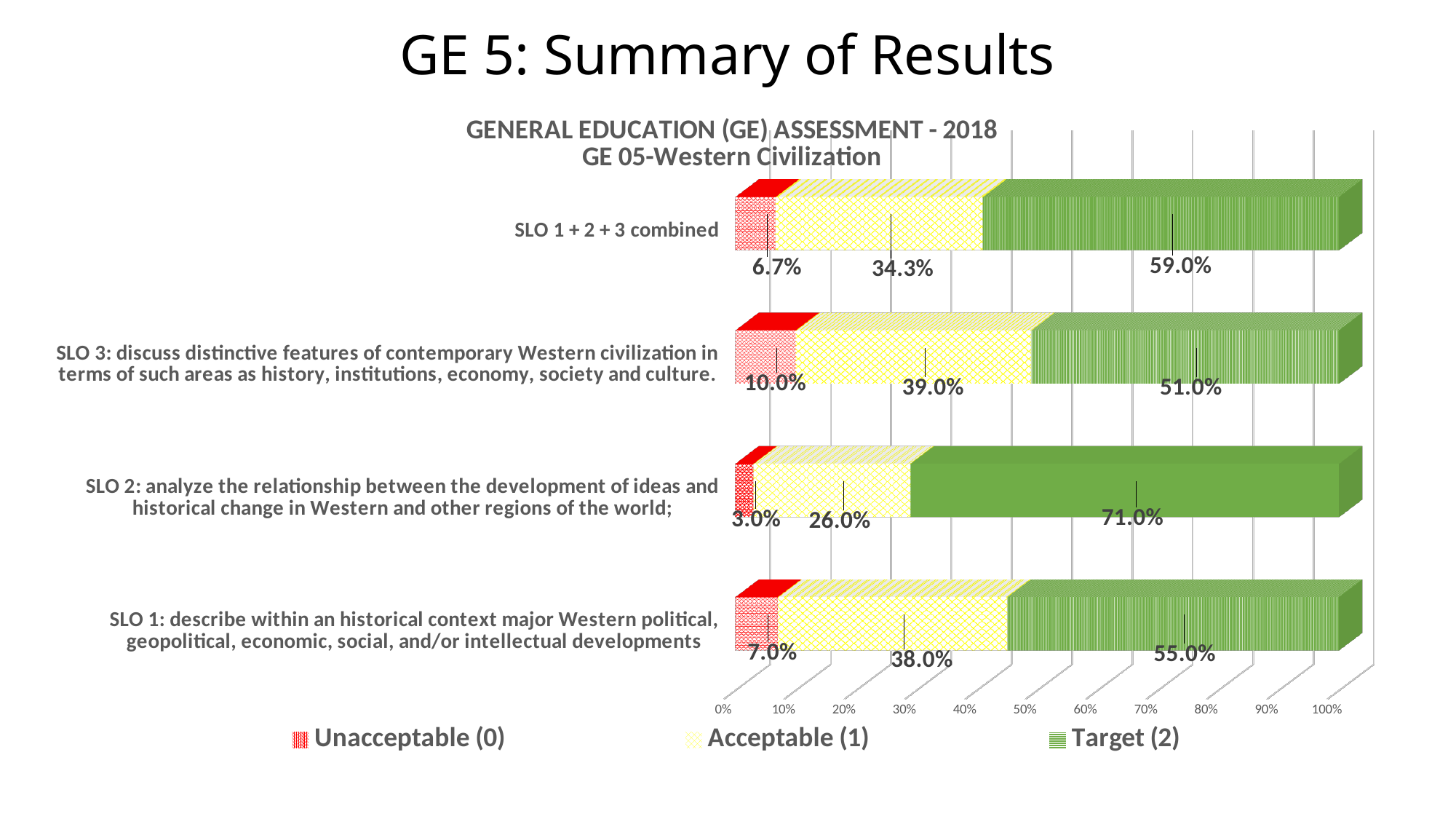
How many series does the legend list? 3 What is the difference between the Target (2) values for SLO 2 and SLO 3? 20.0% Which category has the highest Target (2) value? SLO 2 What is the total of the stacked bar for SLO 1? 100.0% How many categories are shown on the chart? 4 What is the Acceptable (1) value for SLO 1 + 2 + 3 combined? 34.3% What is the Acceptable (1) value for SLO 1? 38.0% Which is larger, the Acceptable (1) value for SLO 3 or for SLO 1? SLO 3 What is the Target (2) value for SLO 2? 71.0% What kind of chart is shown? Stacked bar chart What is the Unacceptable (0) value for SLO 3? 10.0% Which category has the lowest Unacceptable (0) value? SLO 2